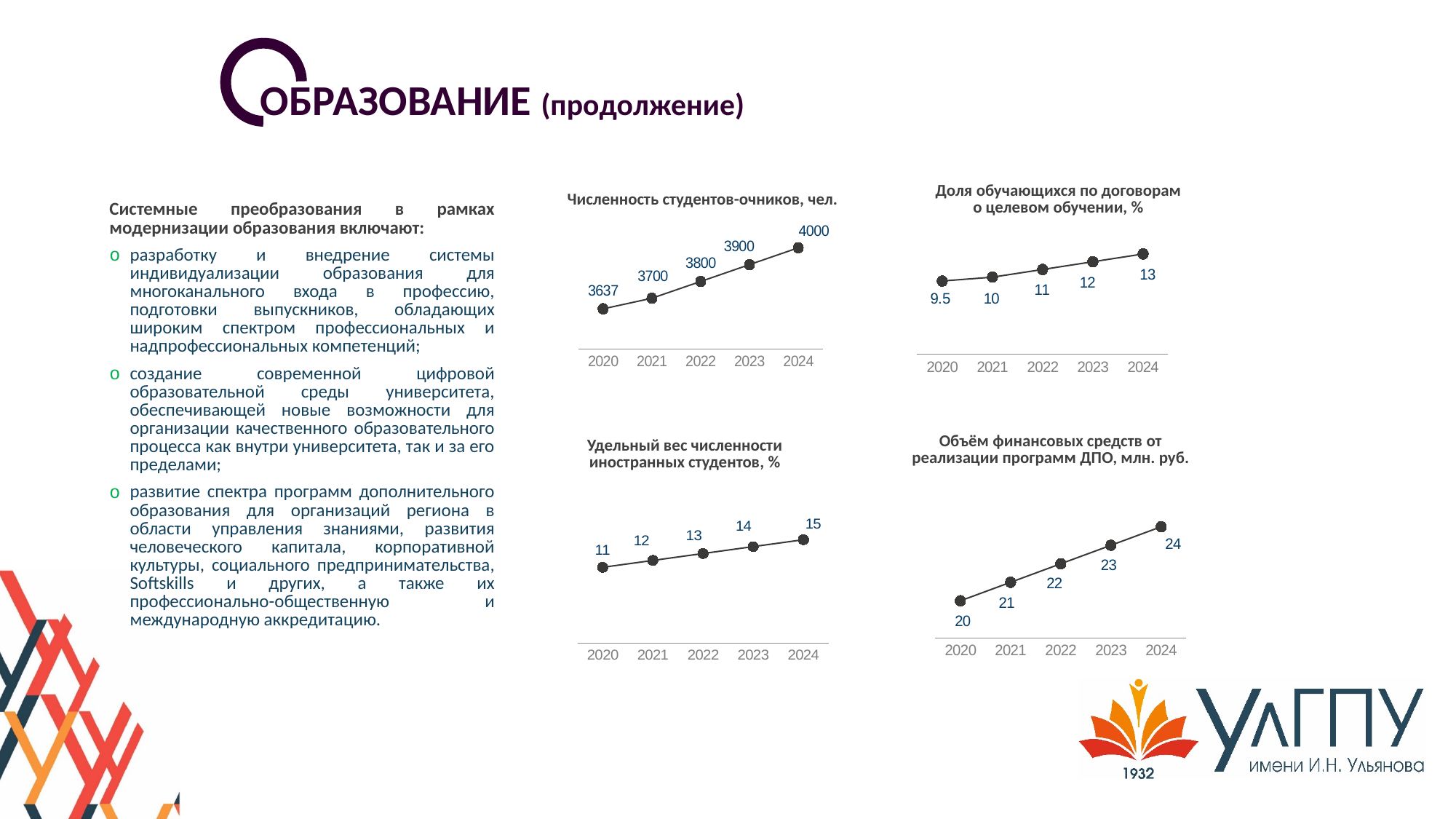
What type of chart is 'Доля обучающихся по договорам о целевом обучении, %'? line chart In the chart 'Доля обучающихся по договорам о целевом обучении, %', which year has the highest value? 2024 In the chart 'Численность студентов-очников, чел.', what is the value for 2024? 4000 In the chart 'Численность студентов-очников, чел.', what is the value for 2020? 3637 How many data points are plotted in the chart 'Численность студентов-очников, чел.'? 5 In the chart 'Объём финансовых средств от реализации программ ДПО, млн. руб.', what is the value for 2023? 23 In the chart 'Численность студентов-очников, чел.', what is the difference between the 2024 and 2020 values? 363 In the chart 'Объём финансовых средств от реализации программ ДПО, млн. руб.', what is the difference between the 2024 and 2020 values? 4 In the chart 'Доля обучающихся по договорам о целевом обучении, %', what is the value for 2020? 9.5 In the chart 'Удельный вес численности иностранных студентов, %', what is the value for 2022? 13 In the chart 'Удельный вес численности иностранных студентов, %', which year has the lowest value? 2020 In the chart 'Объём финансовых средств от реализации программ ДПО, млн. руб.', do the values rise or fall from 2020 to 2024? rise